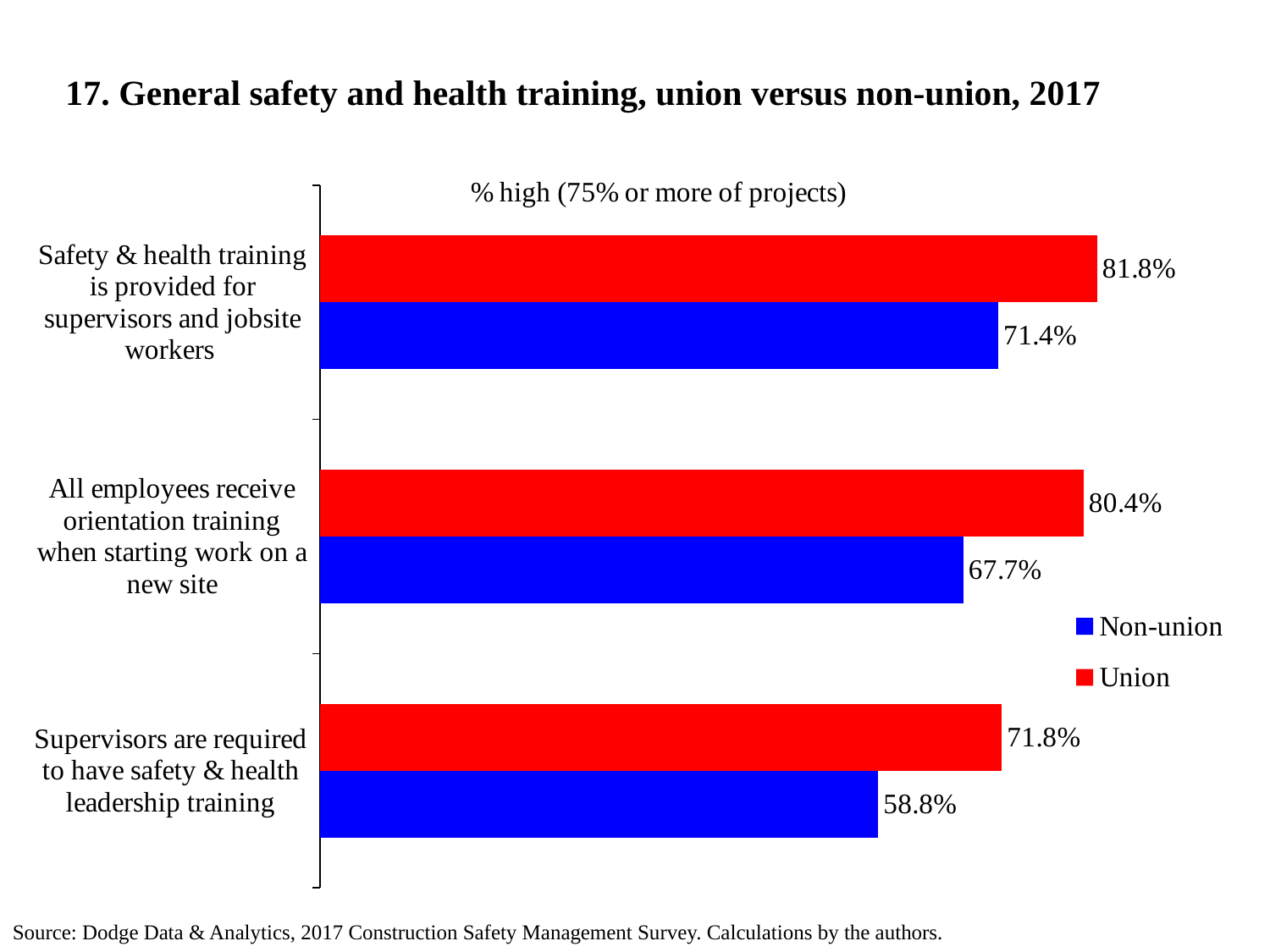
Which category has the highest Union value? Safety & health training is provided for supervisors and jobsite workers What is the Non-union value for "All employees receive orientation training when starting work on a new site"? 67.7% What type of chart is shown on the slide? Bar chart What is the Union value for "Safety & health training is provided for supervisors and jobsite workers"? 81.8% What is the Union value for "Supervisors are required to have safety & health leadership training"? 71.8% How many series does the legend list? 2 What is the difference between the Union and Non-union values for "Supervisors are required to have safety & health leadership training"? 13.0% How many categories are shown on the chart? 3 What is the Non-union value for "Supervisors are required to have safety & health leadership training"? 58.8% What is the difference between the Union and Non-union values for "All employees receive orientation training when starting work on a new site"? 12.7% Which category has the lowest Non-union value? Supervisors are required to have safety & health leadership training For "Safety & health training is provided for supervisors and jobsite workers", which is larger, the Union or Non-union value? Union